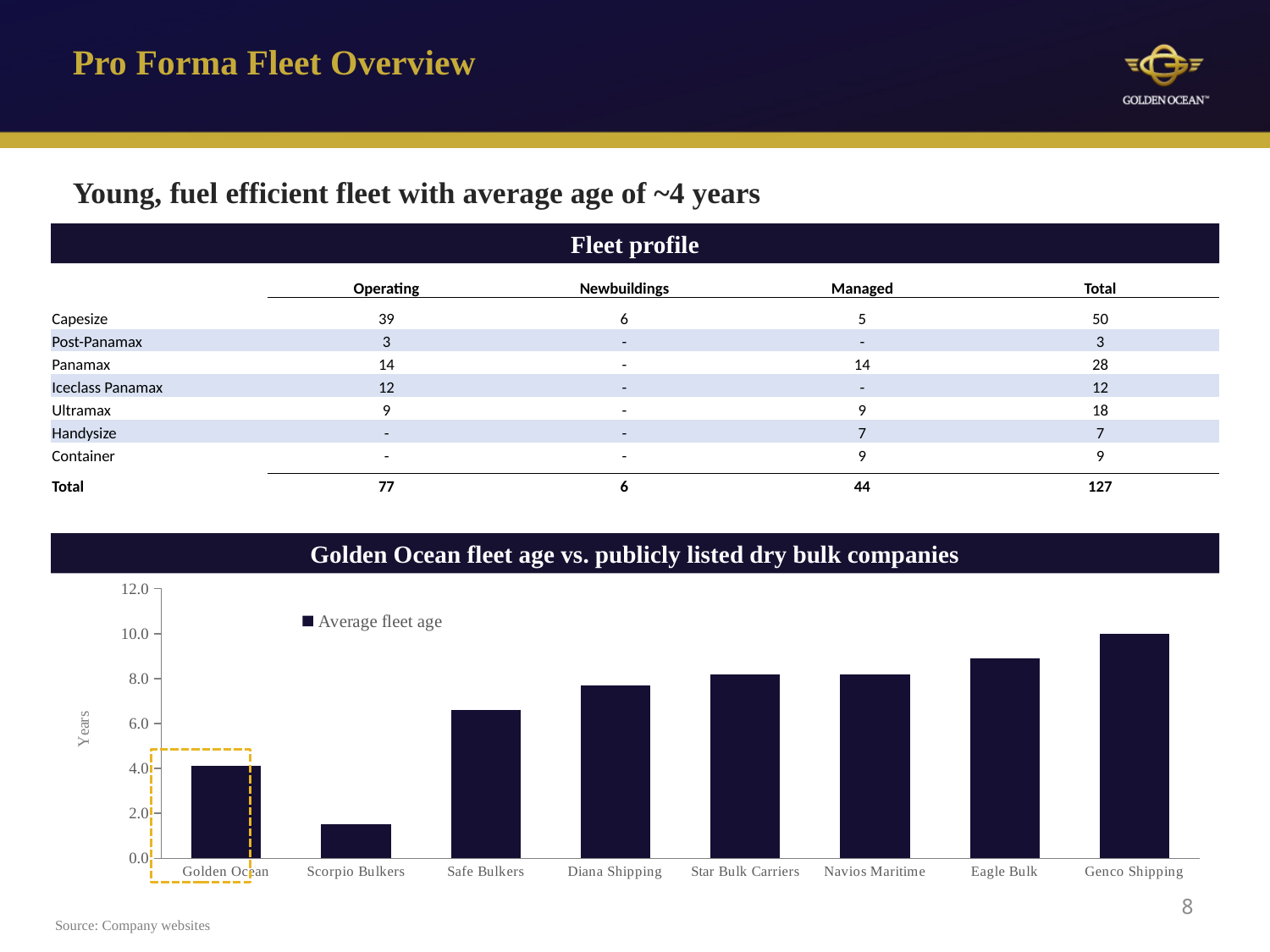
Which has a higher average fleet age, Safe Bulkers or Diana Shipping? Diana Shipping Is the average fleet age for Eagle Bulk greater or less than 8.0 years? greater What is the series name shown in the legend of the fleet age chart? Average fleet age What kind of chart is shown on the slide? bar chart Which company has the highest average fleet age in the chart? Genco Shipping What is the label on the y axis of the fleet age chart? Years Which company has the lowest average fleet age in the chart? Scorpio Bulkers Is the average fleet age for Golden Ocean greater or less than 6.0 years? less How many companies are shown on the x axis of the fleet age chart? 8 Is the average fleet age for Scorpio Bulkers greater or less than 2.0 years? less How many series does the legend of the fleet age chart list? 1